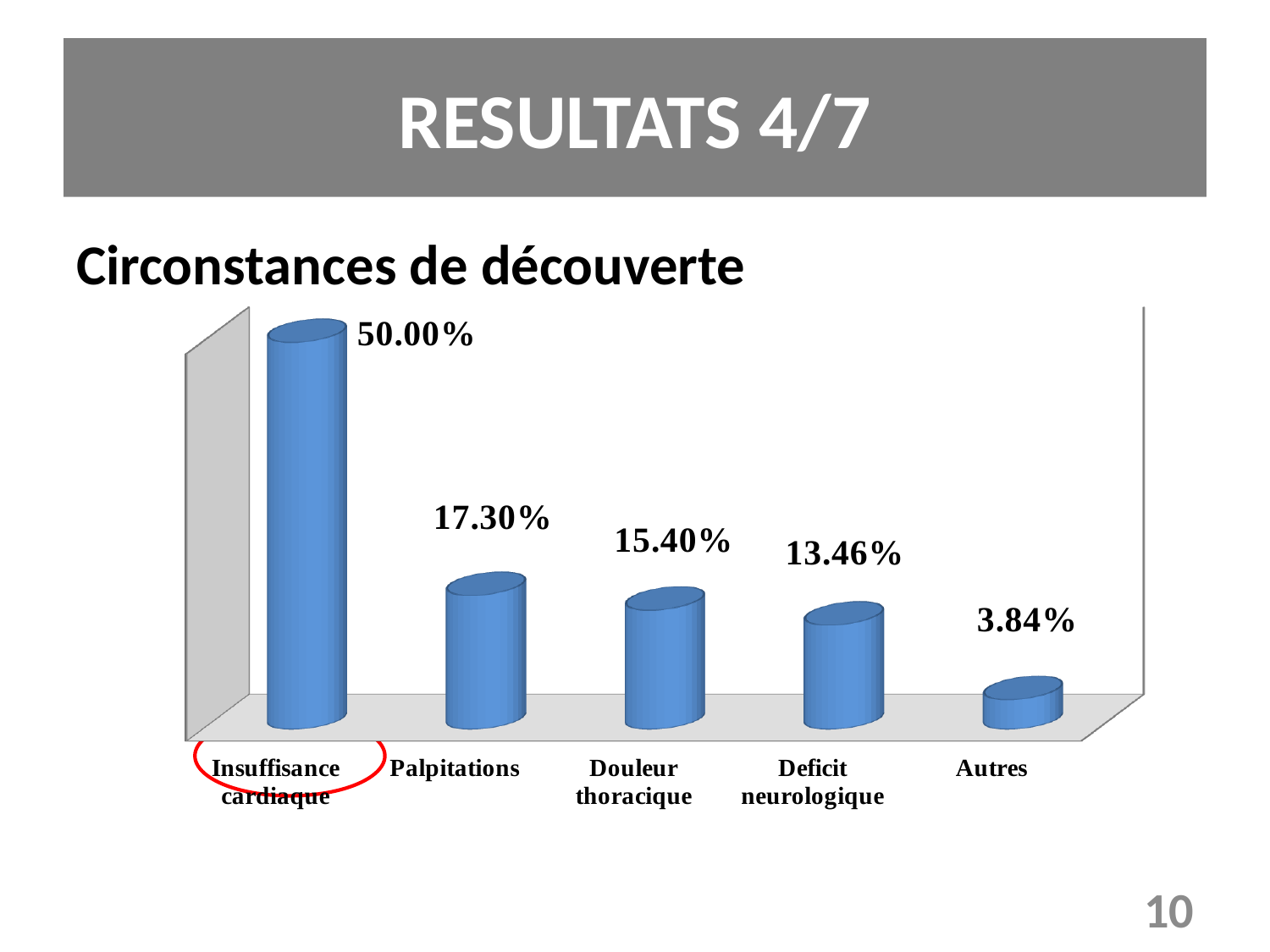
What is the value for Deficit neurologique? 13.46% What kind of chart is shown on the slide? Bar chart What is the value for Palpitations? 17.30% Which is larger, the value for Palpitations or the value for Deficit neurologique? Palpitations What is the value for Douleur thoracique? 15.40% What is the value for Insuffisance cardiaque? 50.00% Which category has the lowest value? Autres What is the value for Autres? 3.84% How many categories are shown in the chart? 5 Which category has the highest value? Insuffisance cardiaque What is the difference between the values for Insuffisance cardiaque and Palpitations? 32.70% What is the difference between the values for Deficit neurologique and Autres? 9.62%